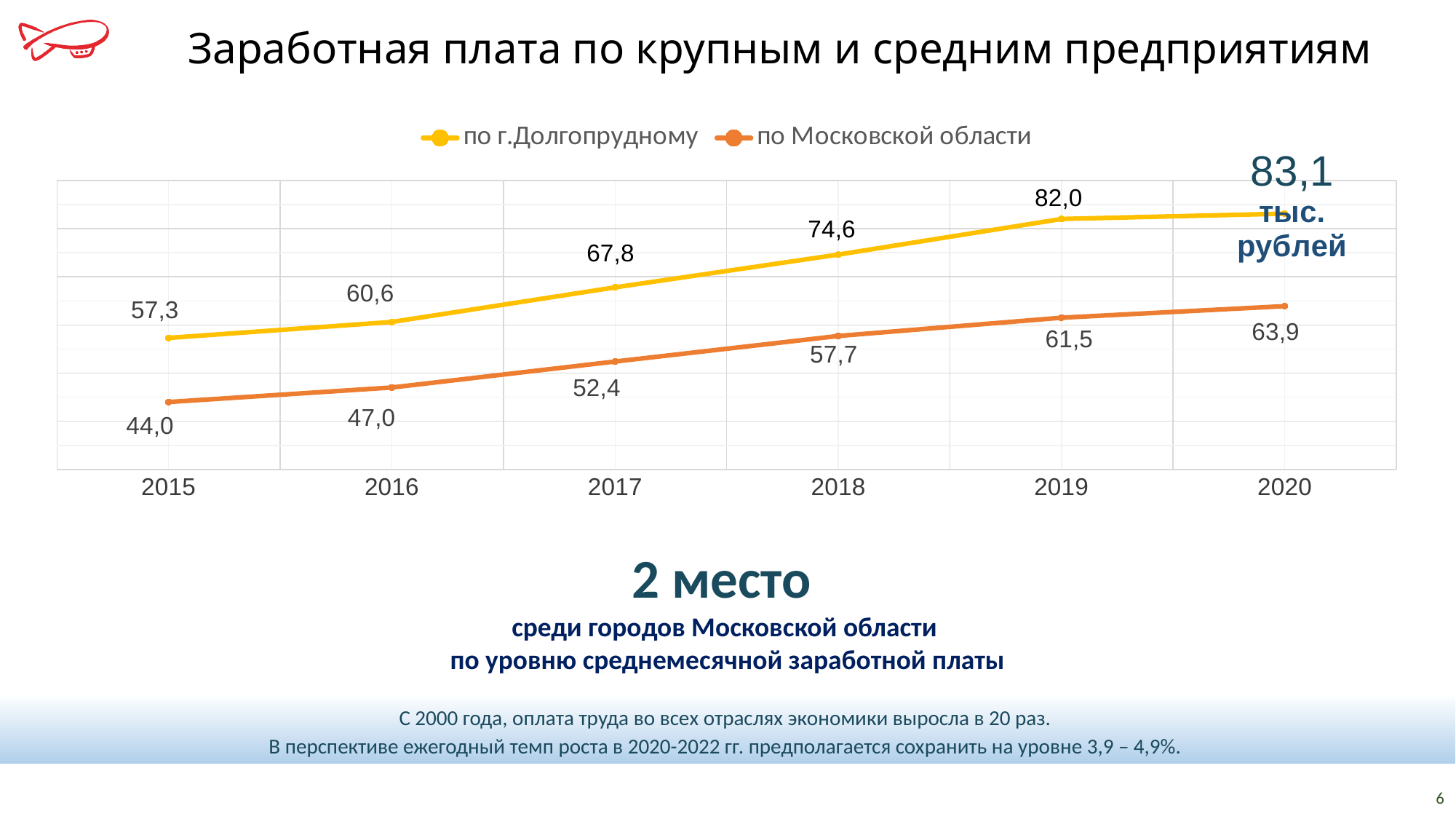
In which year is the value for по Московской области lowest? 2015 What is the difference between по г.Долгопрудному and по Московской области in 2019? 20,5 What is the value for по г.Долгопрудному in 2017? 67,8 Which colour is used for the по Московской области line? Orange What type of chart is shown on the slide? Line chart Which series has the larger value in 2016, по г.Долгопрудному or по Московской области? по г.Долгопрудному How many series does the legend list? 2 What is the value for по Московской области in 2018? 57,7 How many years are shown on the x axis? 6 Do the values for по Московской области rise or fall from 2015 to 2020? Rise What is the value for по г.Долгопрудному in 2020? 83,1 In which year is the value for по г.Долгопрудному highest? 2020